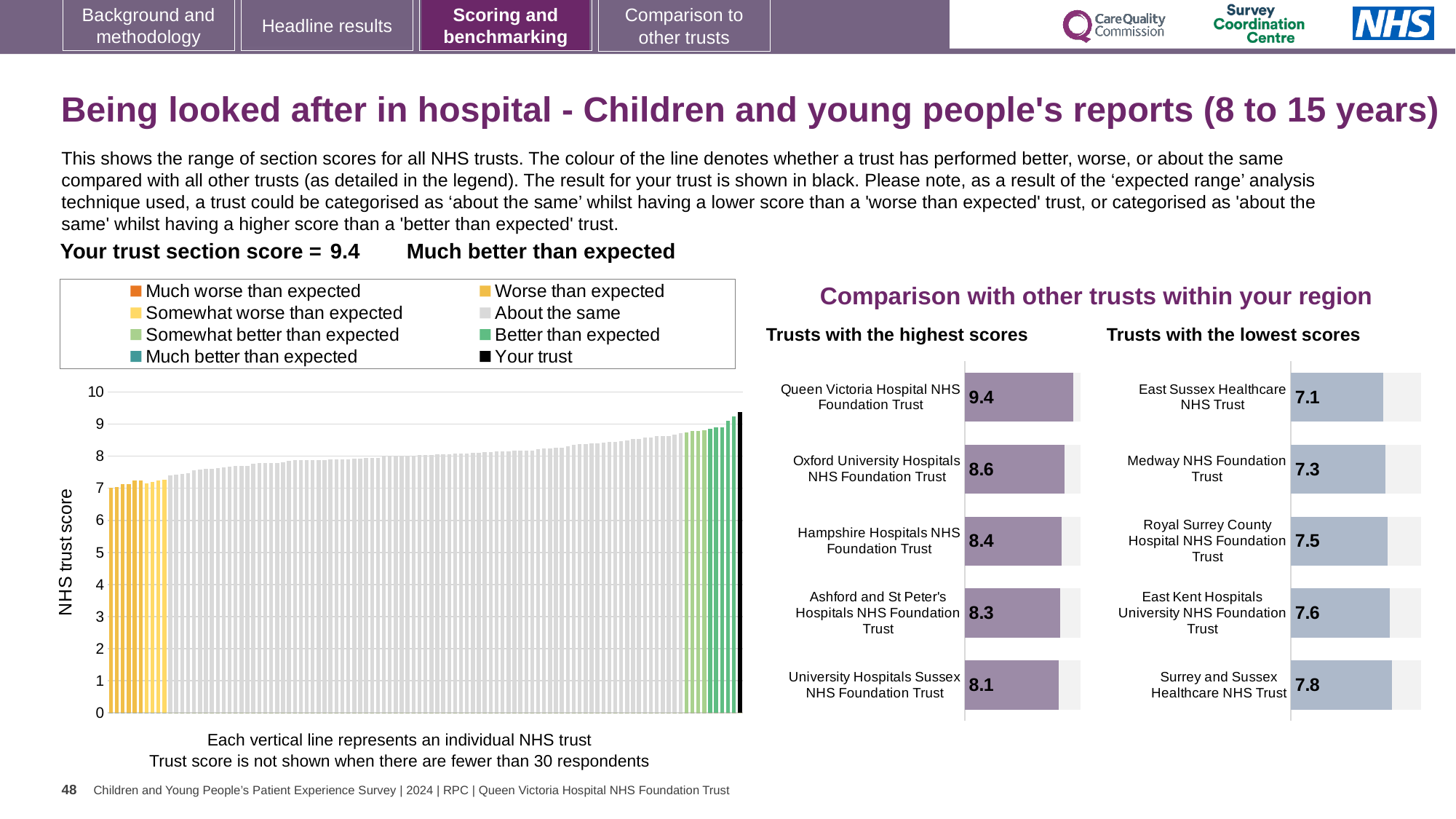
How many trusts are listed in the 'Trusts with the lowest scores' chart? 5 In the 'Trusts with the lowest scores' chart, what is the difference between the scores of Surrey and Sussex Healthcare NHS Trust and East Sussex Healthcare NHS Trust? 0.7 How many entries does the legend above the 'NHS trust score' chart list? 8 Which has a higher score: Ashford and St Peter's Hospitals NHS Foundation Trust in the highest scores chart, or East Kent Hospitals University NHS Foundation Trust in the lowest scores chart? Ashford and St Peter's Hospitals NHS Foundation Trust In the 'Trusts with the lowest scores' chart, which trust has the lowest score? East Sussex Healthcare NHS Trust In the 'Trusts with the highest scores' chart, what is the score for Hampshire Hospitals NHS Foundation Trust? 8.4 In the 'Trusts with the highest scores' chart, which trust has the highest score? Queen Victoria Hospital NHS Foundation Trust In the 'Trusts with the highest scores' chart, what is the difference between the scores of Oxford University Hospitals NHS Foundation Trust and University Hospitals Sussex NHS Foundation Trust? 0.5 In the 'NHS trust score' chart on the left, do the bars rise or fall from left to right? Rise In the 'Trusts with the lowest scores' chart, what is the score for Medway NHS Foundation Trust? 7.3 What kind of chart is the 'NHS trust score' chart on the left? Bar chart In the 'Trusts with the highest scores' chart, what is the score for Queen Victoria Hospital NHS Foundation Trust? 9.4